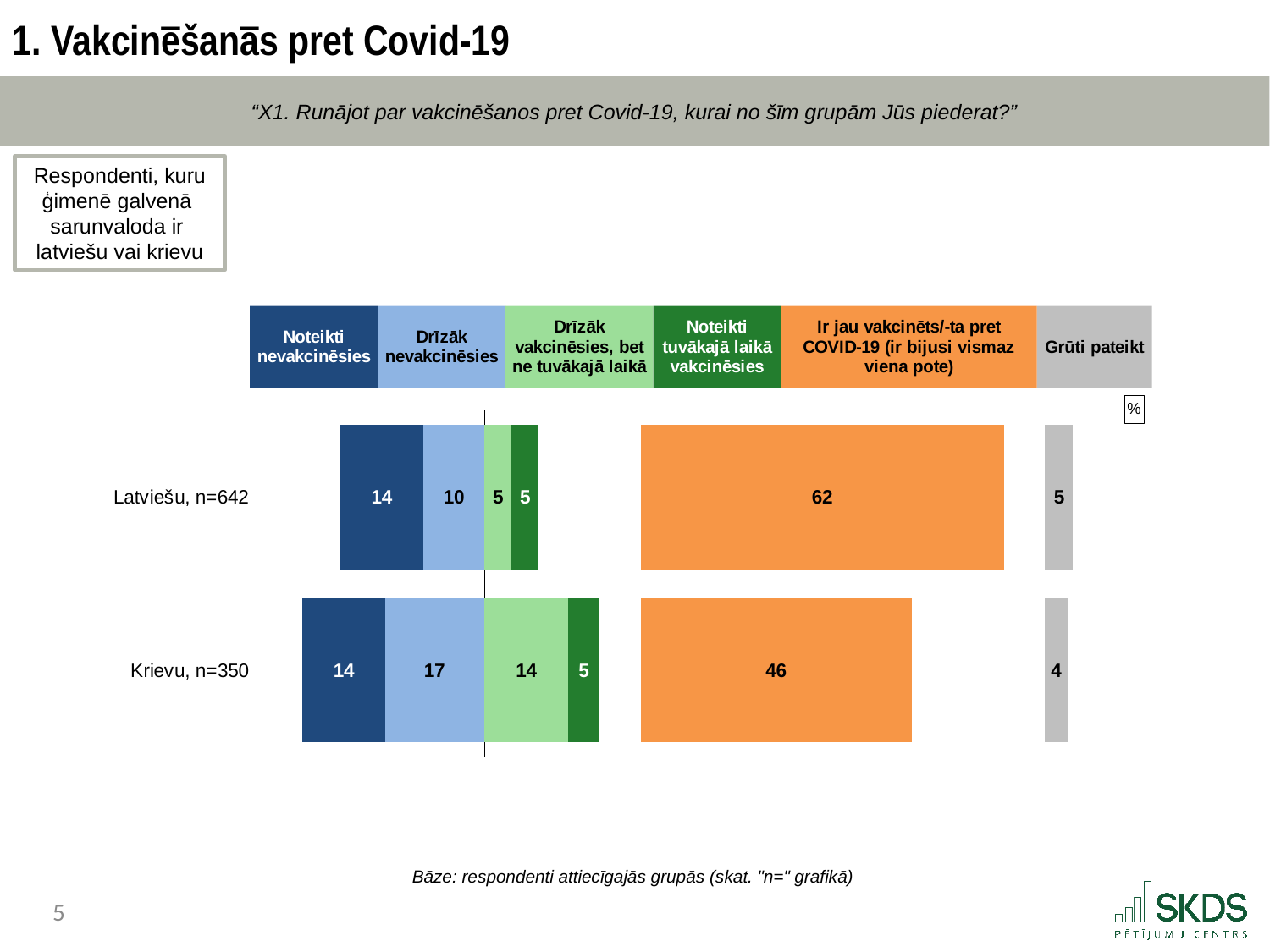
What is the value for "Grūti pateikt" in the Krievu, n=350 group? 4 What percentage of the Latviešu, n=642 group answered "Ir jau vakcinēts/-ta pret COVID-19 (ir bijusi vismaz viena pote)"? 62 Which group has the higher value for "Ir jau vakcinēts/-ta pret COVID-19 (ir bijusi vismaz viena pote)"? Latviešu, n=642 How many respondent groups are shown in the chart? 2 Which answer category has the largest value in the Krievu, n=350 group? Ir jau vakcinēts/-ta pret COVID-19 (ir bijusi vismaz viena pote) How many answer categories does the legend list? 6 What is the value for "Drīzāk vakcinēsies, bet ne tuvākajā laikā" in the Latviešu, n=642 group? 5 Which colour represents "Noteikti nevakcinēsies" in the chart? Dark blue What is the value for "Drīzāk nevakcinēsies" in the Krievu, n=350 group? 17 What is the difference between the "Ir jau vakcinēts/-ta pret COVID-19" values of the Latviešu, n=642 and Krievu, n=350 groups? 16 What type of chart is shown on the slide? Stacked bar chart What is the difference between the "Drīzāk vakcinēsies, bet ne tuvākajā laikā" values of the Krievu, n=350 and Latviešu, n=642 groups? 9